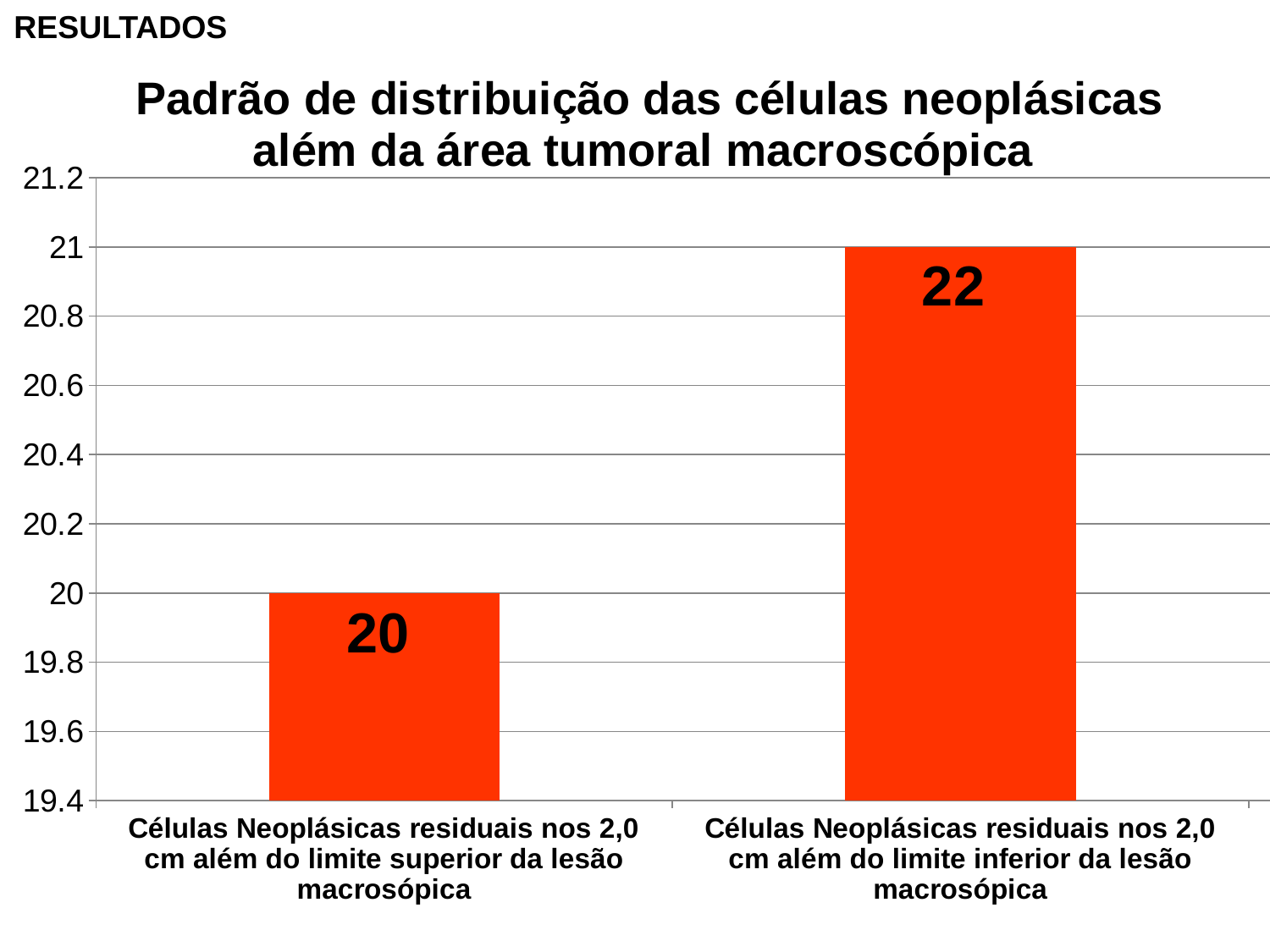
Is the bar for 'Células Neoplásicas residuais nos 2,0 cm além do limite inferior da lesão macrosópica' greater or less than 20.4 on the axis? greater What is the data label on the bar for 'Células Neoplásicas residuais nos 2,0 cm além do limite inferior da lesão macrosópica'? 22 What colour are the bars in the chart? orange-red Which is larger: the bar for the limite superior category or the bar for the limite inferior category? limite inferior Which category has the highest bar? Células Neoplásicas residuais nos 2,0 cm além do limite inferior da lesão macrosópica What is the data label on the bar for 'Células Neoplásicas residuais nos 2,0 cm além do limite superior da lesão macrosópica'? 20 What is the title of the chart? Padrão de distribuição das células neoplásicas além da área tumoral macroscópica What kind of chart is shown on the slide? bar chart Which category has the lowest bar? Células Neoplásicas residuais nos 2,0 cm além do limite superior da lesão macrosópica How many categories are shown in the chart? 2 Do the bar values rise or fall from left to right? rise Is the bar for 'Células Neoplásicas residuais nos 2,0 cm além do limite superior da lesão macrosópica' greater or less than 20.4 on the axis? less